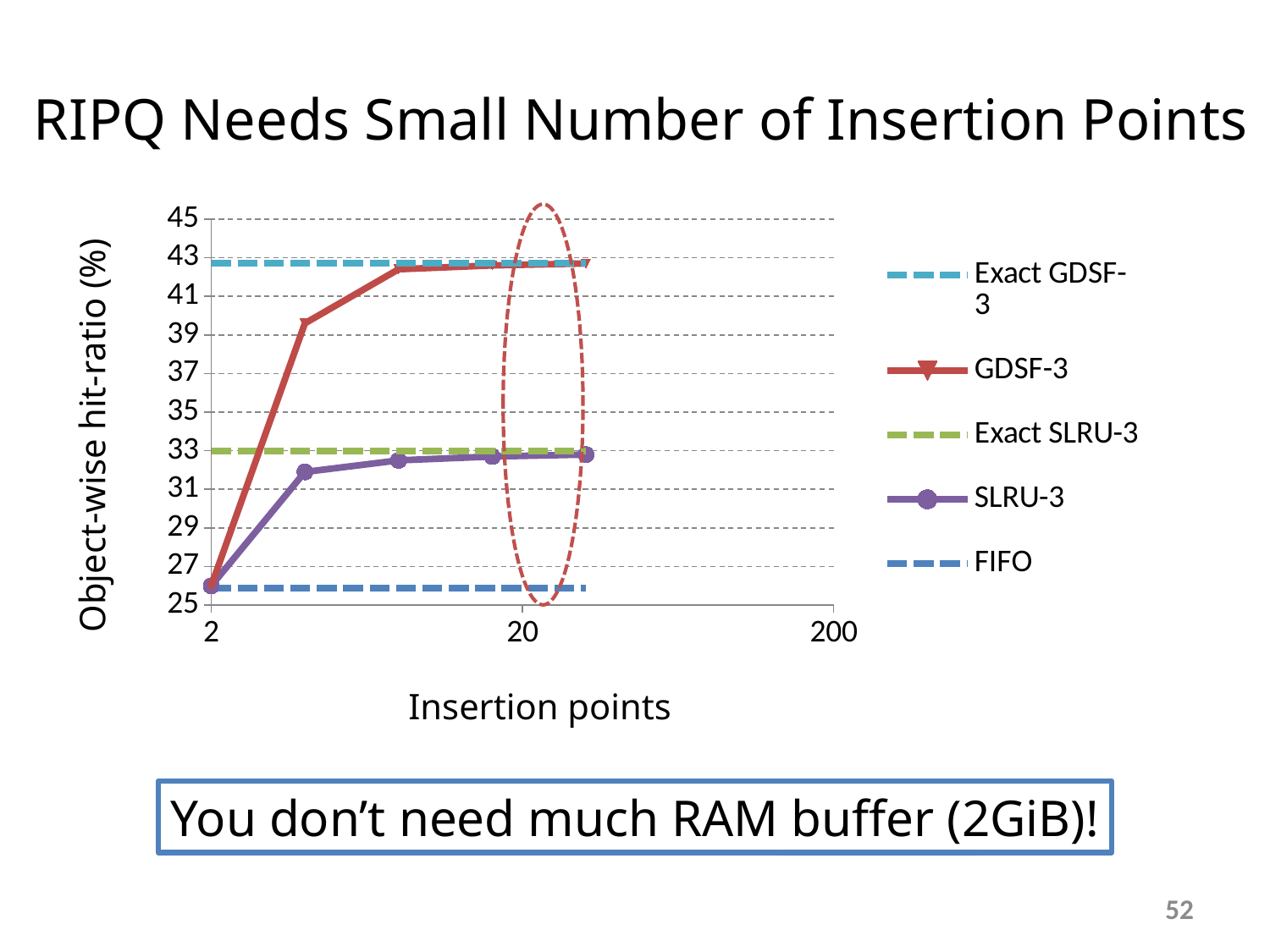
Is the value for GDSF-3 at 2 insertion points greater or less than 29? less Is the value for GDSF-3 at 20 insertion points greater or less than 41? greater Which is higher, the Exact GDSF-3 line or the Exact SLRU-3 line? Exact GDSF-3 How many series does the legend list? 5 What kind of chart is shown on the slide? line chart Does the GDSF-3 hit-ratio rise or fall as the number of insertion points increases? rise What is the title of the chart on the slide? RIPQ Needs Small Number of Insertion Points What is the label of the y axis? Object-wise hit-ratio (%) Is the value for SLRU-3 at 20 insertion points greater or less than 31? greater At 20 insertion points, which has the higher hit-ratio, GDSF-3 or SLRU-3? GDSF-3 Which of the dashed reference lines has the lowest hit-ratio? FIFO